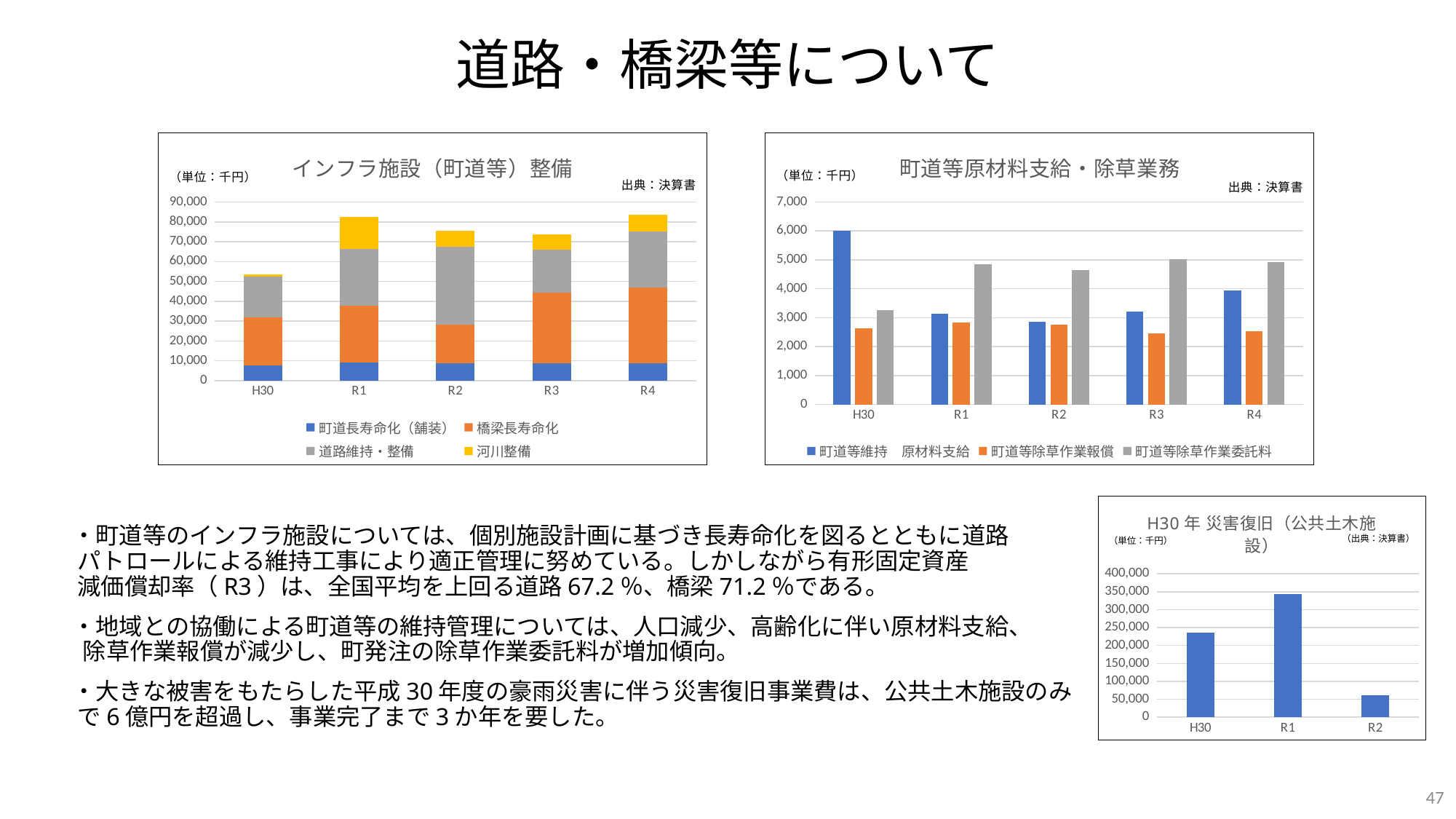
In the '町道等原材料支給・除草業務' chart, which year has the highest value for 町道等維持 原材料支給? H30 In the '町道等原材料支給・除草業務' chart, which year has the lowest value for 町道等除草作業委託料? H30 In the 'H30年 災害復旧（公共土木施設）' chart, is the value for R2 greater or less than 100,000? less What unit is stated for the values in the 'H30年 災害復旧（公共土木施設）' chart? 千円 How many series does the legend of the 'インフラ施設（町道等）整備' chart list? 4 In the 'インフラ施設（町道等）整備' chart, which year has the lowest total? H30 In the 'H30年 災害復旧（公共土木施設）' chart, which year has the highest value? R1 In the '町道等原材料支給・除草業務' chart, which is larger in R4: 町道等維持 原材料支給 or 町道等除草作業委託料? 町道等除草作業委託料 In the 'インフラ施設（町道等）整備' chart, is the total for H30 greater or less than 60,000? less In the '町道等原材料支給・除草業務' chart, is the value for 町道等維持 原材料支給 in H30 greater or less than 5,000? greater How many years are shown on the x axis of the '町道等原材料支給・除草業務' chart? 5 What kind of chart is the 'インフラ施設（町道等）整備' chart? stacked bar chart